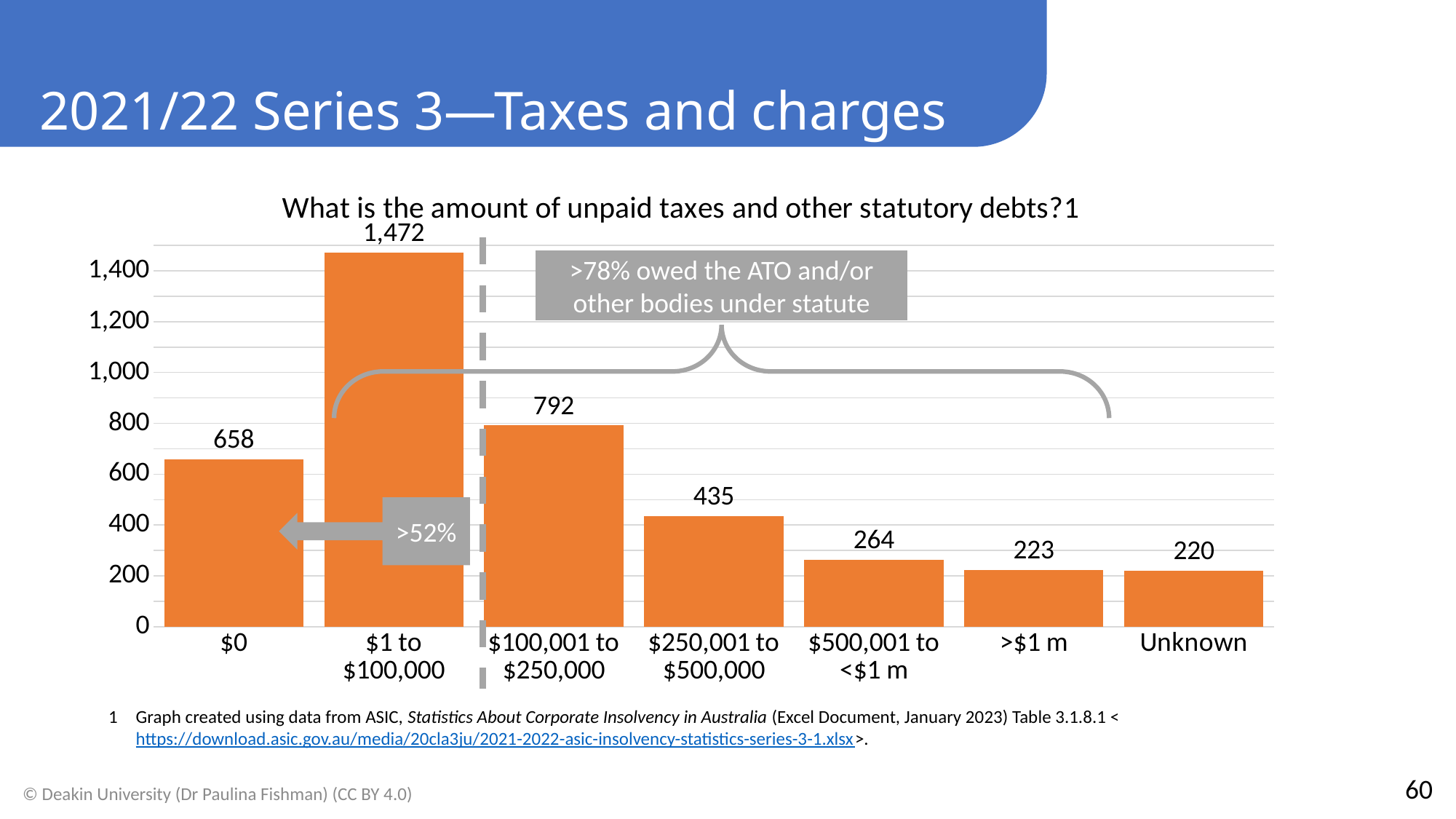
What is the value for the Unknown category? 220 Which category has the lowest value? Unknown How many categories are shown on the x axis? 7 What is the title of the chart? What is the amount of unpaid taxes and other statutory debts? Which is larger, the value for $0 or the value for $100,001 to $250,000? $100,001 to $250,000 Is the value for $250,001 to $500,000 greater or less than 400? greater What kind of chart is shown on the slide? bar chart Which category has the highest value? $1 to $100,000 What is the difference between the values for $1 to $100,000 and $100,001 to $250,000? 680 What is the value for the $250,001 to $500,000 category? 435 What is the value for the $1 to $100,000 category? 1,472 What is the difference between the values for $0 and $500,001 to <$1 m? 394